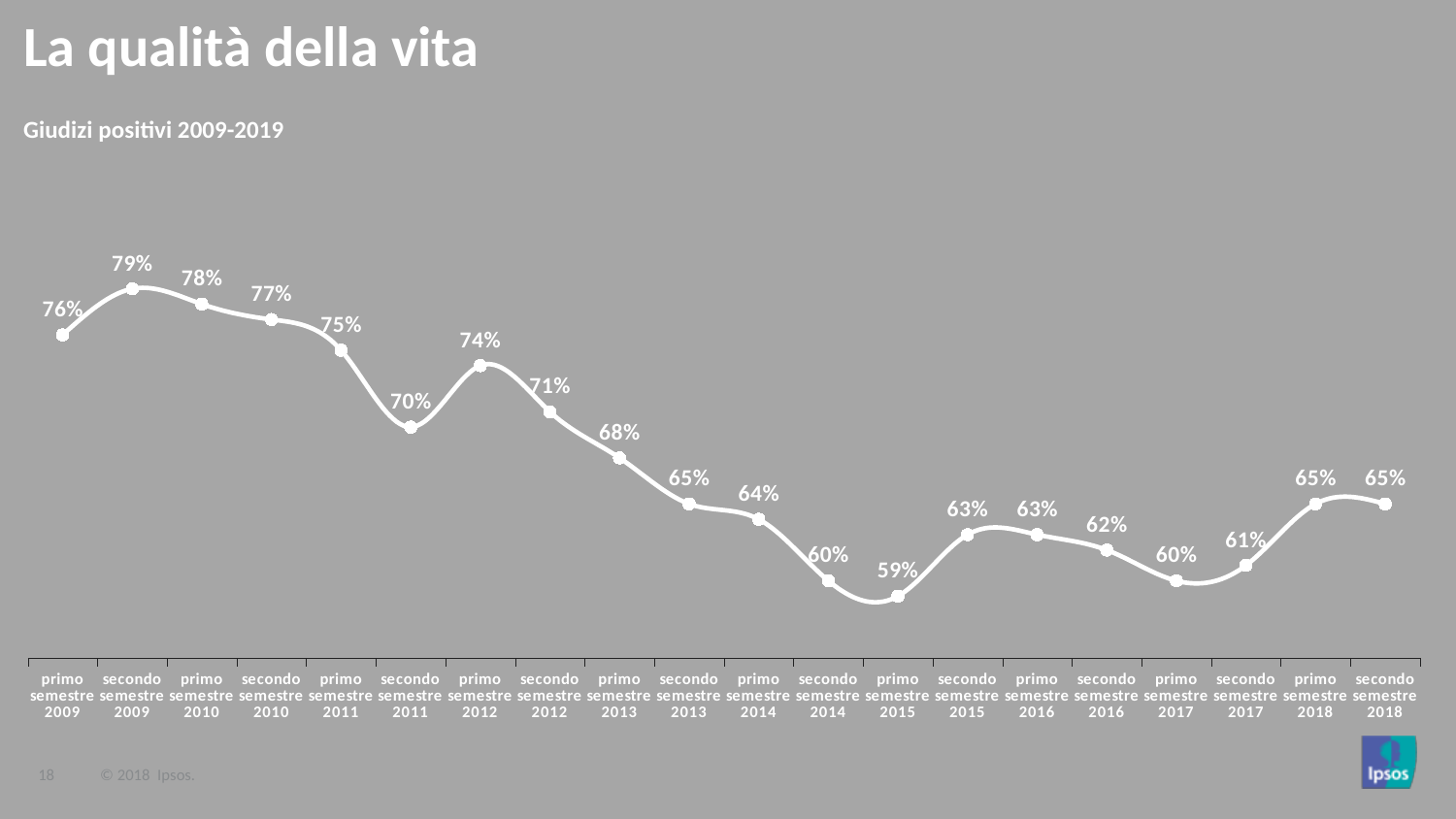
What is the value for secondo semestre 2018? 65% How many data points are plotted on the chart? 20 What is the value for primo semestre 2009? 76% Which period has the lowest value? primo semestre 2015 What is the value for primo semestre 2015? 59% Which period has the highest value? secondo semestre 2009 Do the values generally rise or fall from primo semestre 2009 to secondo semestre 2018? fall What is the difference between the value for secondo semestre 2009 and the value for primo semestre 2015? 20 percentage points What kind of chart is shown on the slide? line chart Which is larger, the value for primo semestre 2012 or the value for secondo semestre 2012? primo semestre 2012 What is the subtitle of the chart? Giudizi positivi 2009-2019 What is the value for secondo semestre 2011? 70%